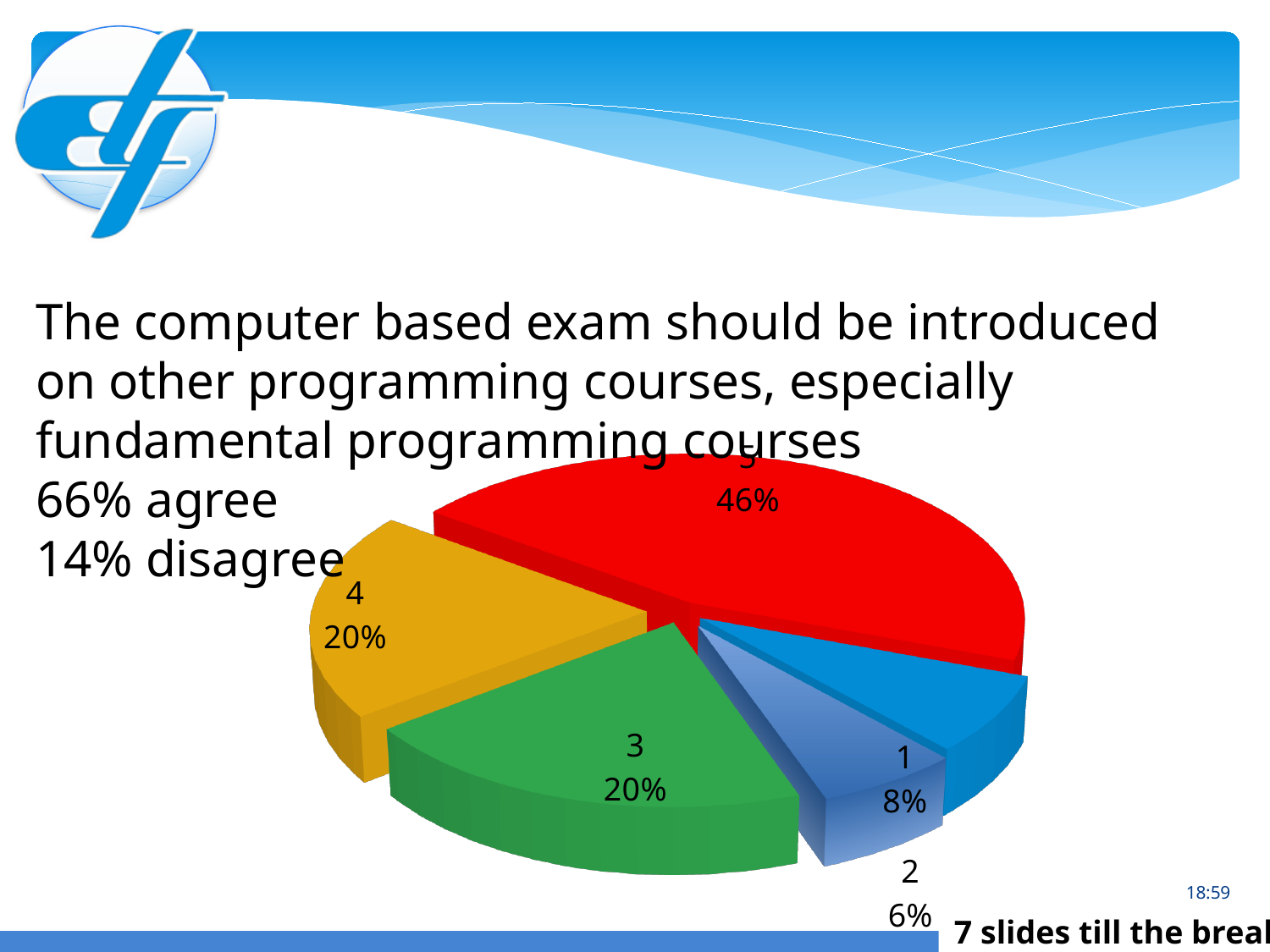
What percentage is shown for slice 1 of the pie chart? 8% Which labelled slice of the pie chart has the smallest share? 2 What percentage is shown on the red slice of the pie chart? 46% Which is larger in the pie chart, slice 1 or slice 2? slice 1 What kind of chart is shown on the slide? pie chart What percentage is shown for slice 4 of the pie chart? 20% Which colour slice of the pie chart has the largest share? red What percentage is shown for slice 3 of the pie chart? 20% How many slices does the pie chart have? 5 What colour is slice 3 in the pie chart? green What is the difference in percentage points between slice 3 and slice 1 of the pie chart? 12 What percentage is shown for slice 2 of the pie chart? 6%